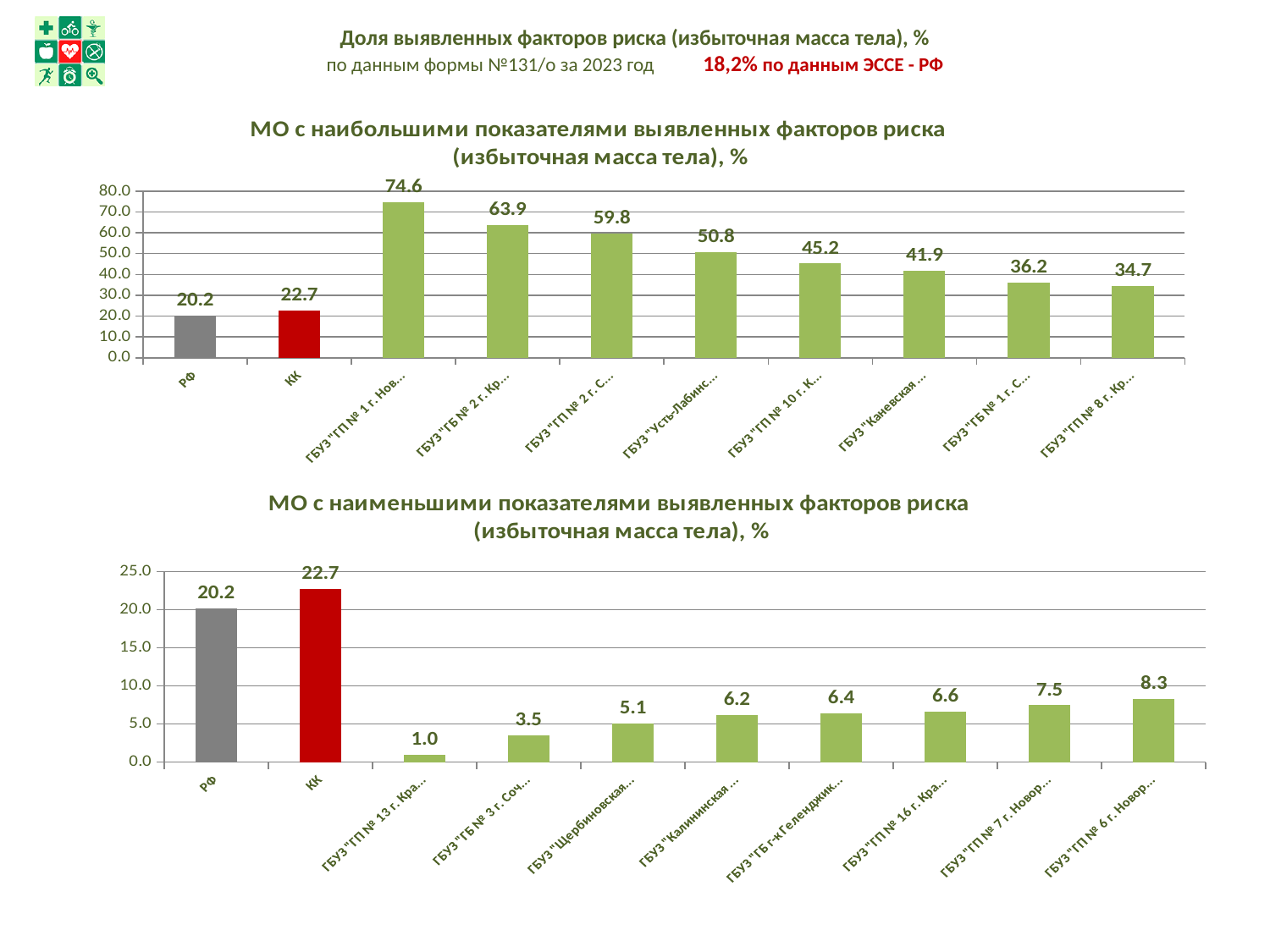
In the top chart (МО с наибольшими показателями), what is the difference between the value for ГБУЗ "ГП № 1 г. Нов..." and the value for РФ? 54.4 In the top chart (МО с наибольшими показателями), which category has the highest value? ГБУЗ "ГП № 1 г. Нов..." In the top chart (МО с наибольшими показателями), what is the value for the bar labelled ГБУЗ "Усть-Лабинс..."? 50.8 In the bottom chart (МО с наименьшими показателями), what is the difference between the value for КК and the value for РФ? 2.5 In the top chart (МО с наибольшими показателями), how many bars are plotted? 10 In the top chart (МО с наибольшими показателями), do the green bars rise or fall from left to right? fall In the top chart (МО с наибольшими показателями), what colour is the bar for КК? red In the bottom chart (МО с наименьшими показателями), what is the value for the bar labelled ГБУЗ "ГП № 13 г. Кра..."? 1.0 In the bottom chart (МО с наименьшими показателями), which category has the lowest value? ГБУЗ "ГП № 13 г. Кра..." What kind of chart is the bottom chart (МО с наименьшими показателями)? bar chart In the top chart (МО с наибольшими показателями), what is the value for КК? 22.7 In the bottom chart (МО с наименьшими показателями), which is larger: the value for ГБУЗ "Щербиновская..." or the value for ГБУЗ "ГП № 7 г. Новор..."? ГБУЗ "ГП № 7 г. Новор..."